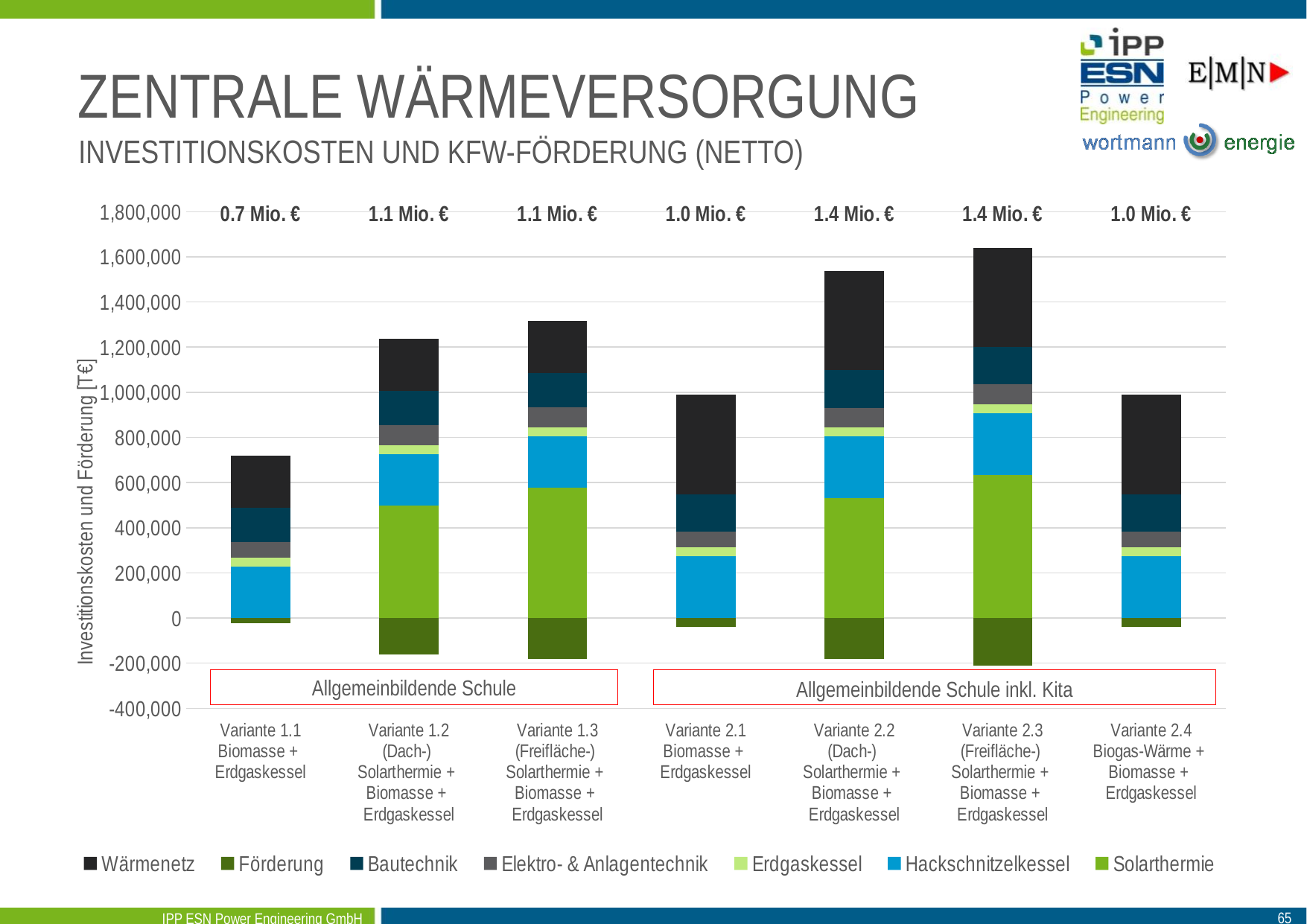
What is the label of the vertical axis? Investitionskosten und Förderung [T€] Which variant has the tallest stacked bar? Variante 2.3 Is the top of the stacked bar for Variante 1.1 greater or less than 800,000? less What total investment cost is printed above the bar for Variante 2.4? 1.0 Mio. € Is the top of the stacked bar for Variante 1.3 greater or less than 1,200,000? greater Which has the larger printed total investment cost, Variante 1.1 or Variante 2.1? Variante 2.1 How many series does the legend list? 7 What kind of chart is shown on the slide? stacked bar chart Which variant has the lowest printed total investment cost? Variante 1.1 How many variants (bars) are shown in the chart? 7 What total investment cost is printed above the bar for Variante 1.1? 0.7 Mio. € What total investment cost is printed above the bar for Variante 2.2? 1.4 Mio. €